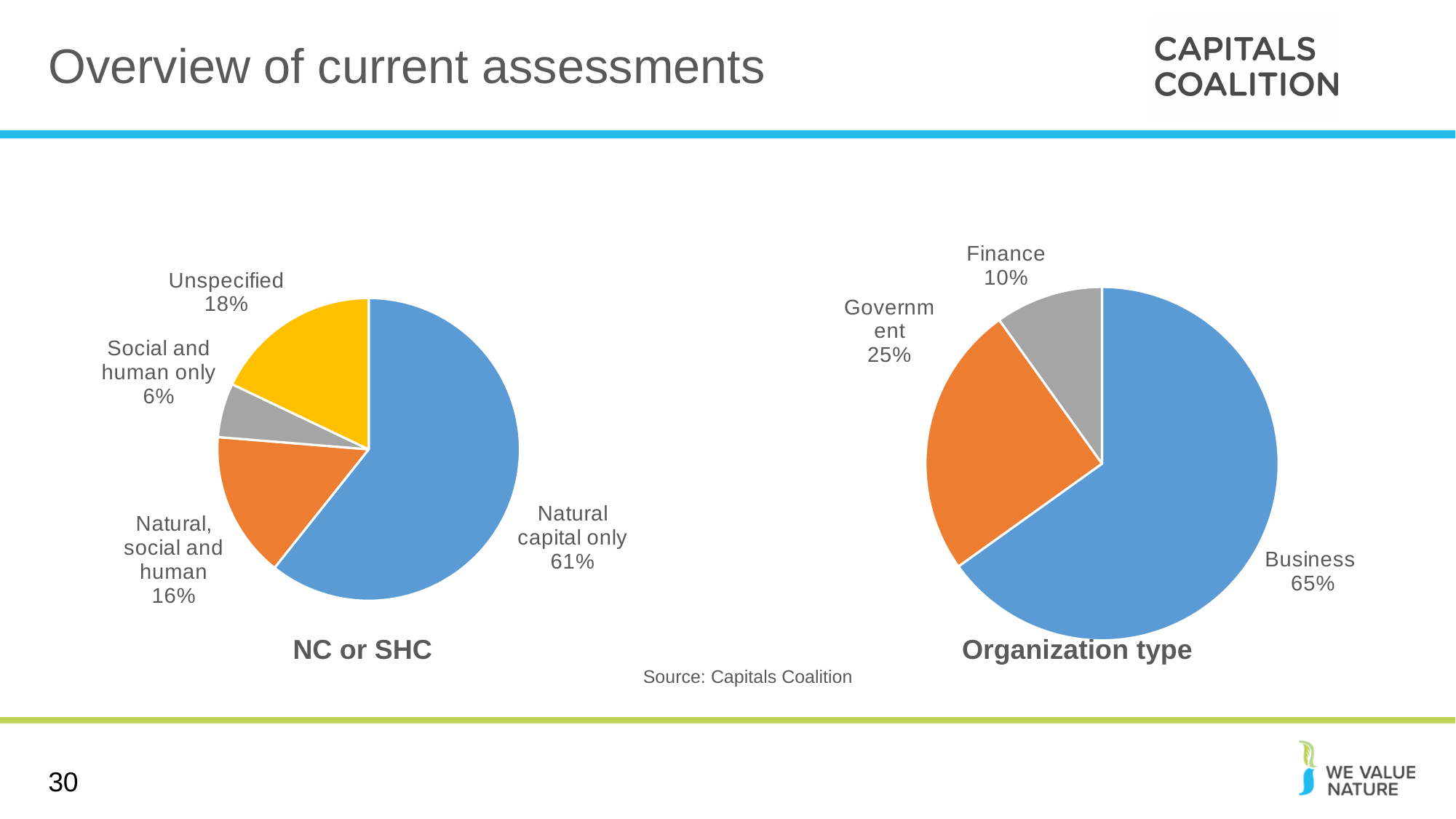
In the 'NC or SHC' chart, which category has the smallest share? Social and human only What kind of chart is the 'Organization type' chart? Pie chart In the 'NC or SHC' chart, which is larger: 'Unspecified' or 'Natural, social and human'? Unspecified In the 'NC or SHC' chart, what share is 'Unspecified'? 18% In the 'Organization type' chart, what is the difference between 'Business' and 'Government'? 40% In the 'NC or SHC' chart, what is the difference between 'Unspecified' and 'Natural, social and human'? 2% In the 'Organization type' chart, which category has the largest share? Business How many slices does the 'NC or SHC' chart have? 4 In the 'Organization type' chart, what share is 'Finance'? 10% In the 'NC or SHC' chart, what share is 'Social and human only'? 6% In the 'NC or SHC' chart, what share is 'Natural capital only'? 61% In the 'Organization type' chart, what share is 'Government'? 25%